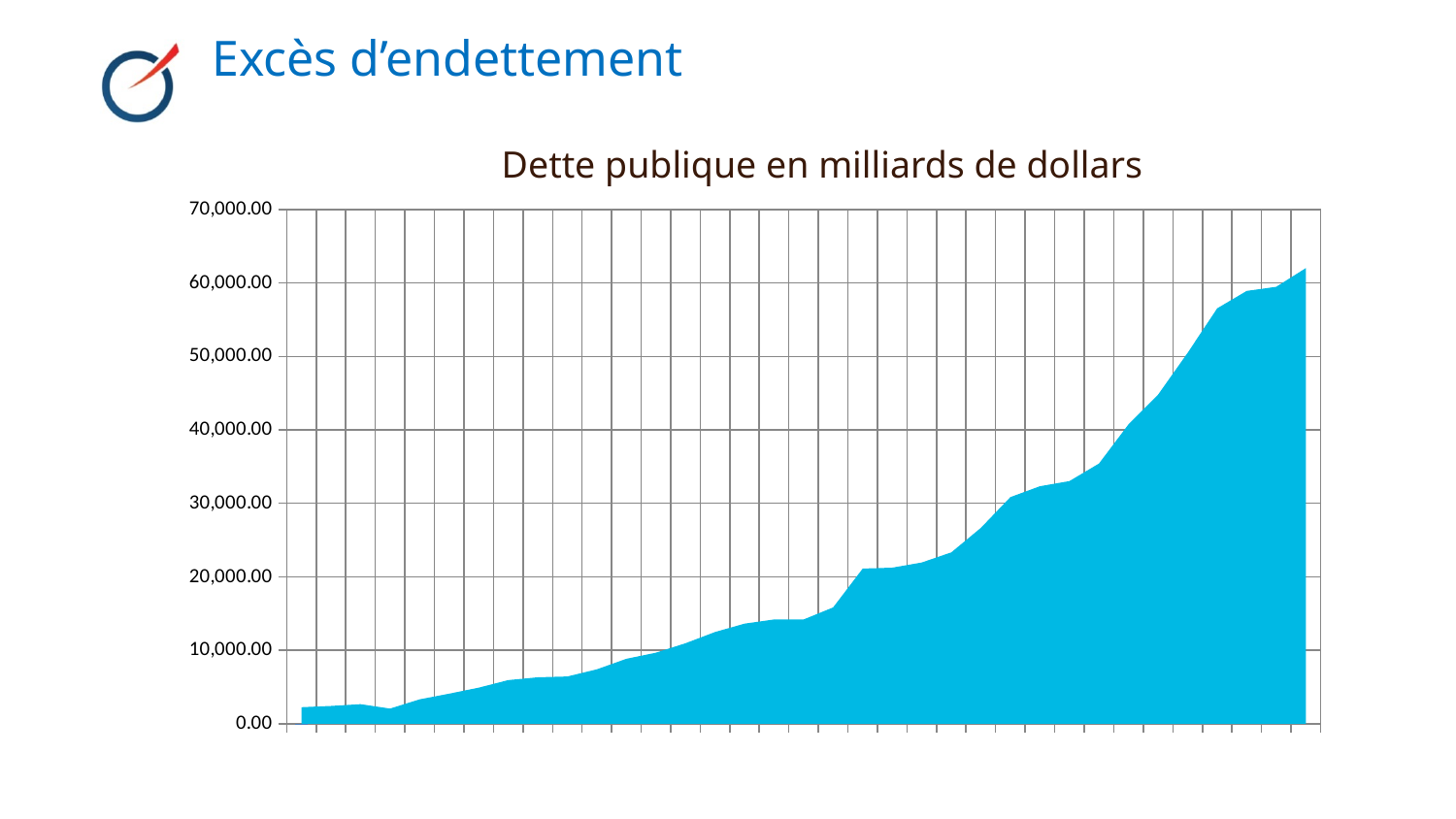
Do the values in the chart generally rise or fall from left to right along the x axis? Rise Is the value at the midpoint of the x axis greater or less than 20,000.00? less Where along the x axis does the chart reach its highest value: at the left end or the right end? Right end Which is larger: the value at the right end of the chart or the value at the left end? The value at the right end What is the highest value shown on the y axis of the chart? 70,000.00 What is the title of the chart? Dette publique en milliards de dollars Is the value at the rightmost point of the chart greater or less than 50,000.00? greater What kind of chart is shown on the slide? Area chart Is the value at the leftmost point of the chart greater or less than 10,000.00? less